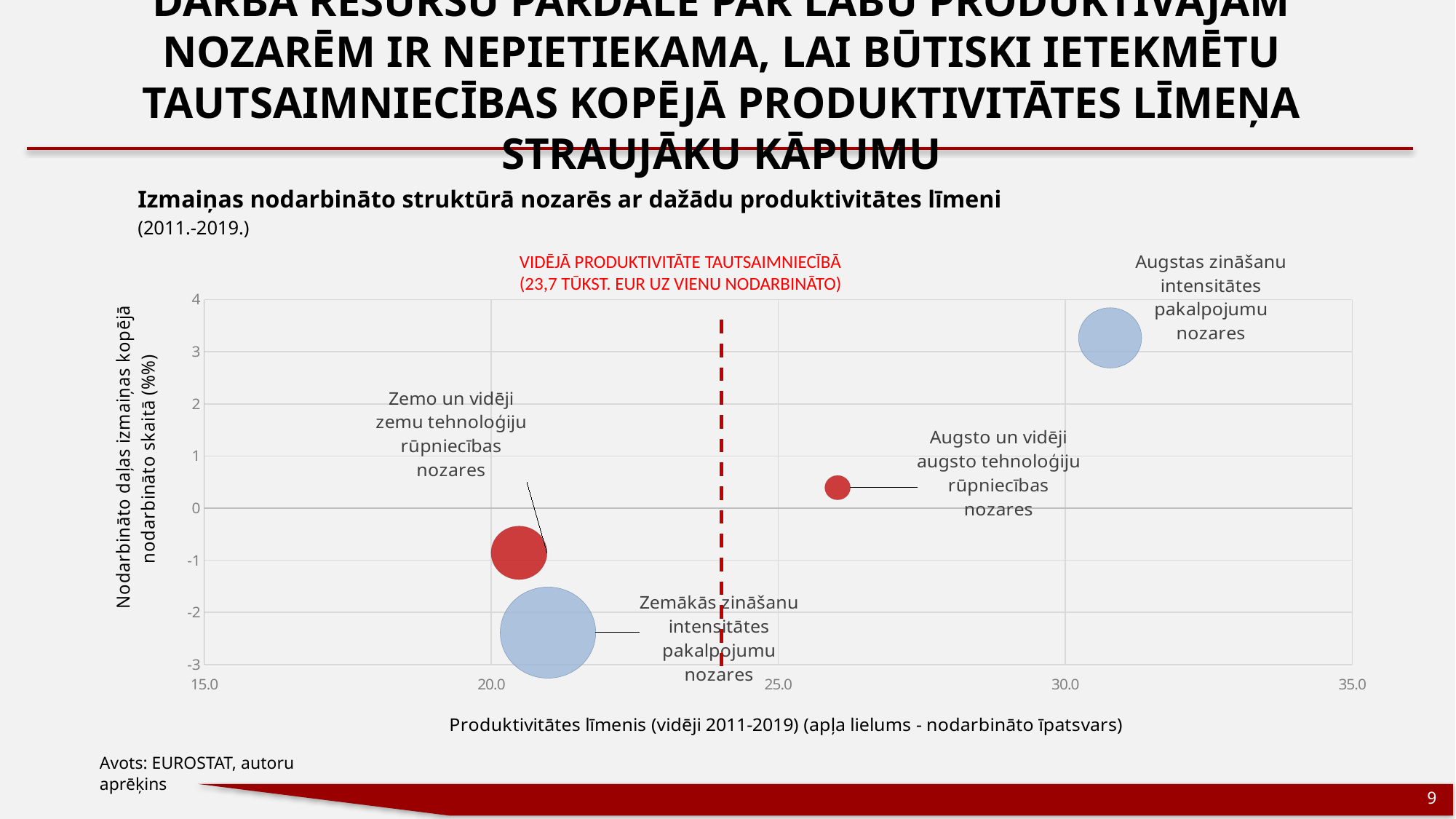
Is the change in share of employed for Augstas zināšanu intensitātes pakalpojumu nozares greater or less than 2? greater Which sector group has the lowest change in share of employed (lowest position on the y axis)? Zemākās zināšanu intensitātes pakalpojumu nozares Is the change in share of employed for Zemo un vidēji zemu tehnoloģiju rūpniecības nozares greater or less than 0? less Which has a higher productivity level: Augstas zināšanu intensitātes pakalpojumu nozares or Augsto un vidēji augsto tehnoloģiju rūpniecības nozares? Augstas zināšanu intensitātes pakalpojumu nozares Is the productivity level for Augsto un vidēji augsto tehnoloģiju rūpniecības nozares greater or less than 25.0? greater What average productivity value in the economy is marked by the dashed vertical line? 23,7 tūkst. EUR uz vienu nodarbināto What kind of chart is shown on the slide? Bubble chart Which has a higher change in share of employed: Augsto un vidēji augsto tehnoloģiju rūpniecības nozares or Zemo un vidēji zemu tehnoloģiju rūpniecības nozares? Augsto un vidēji augsto tehnoloģiju rūpniecības nozares Which sector group has the highest change in share of employed (highest position on the y axis)? Augstas zināšanu intensitātes pakalpojumu nozares How many bubbles (sector groups) are plotted on the chart? 4 What period does the chart title say the changes in employment structure cover? 2011.-2019.